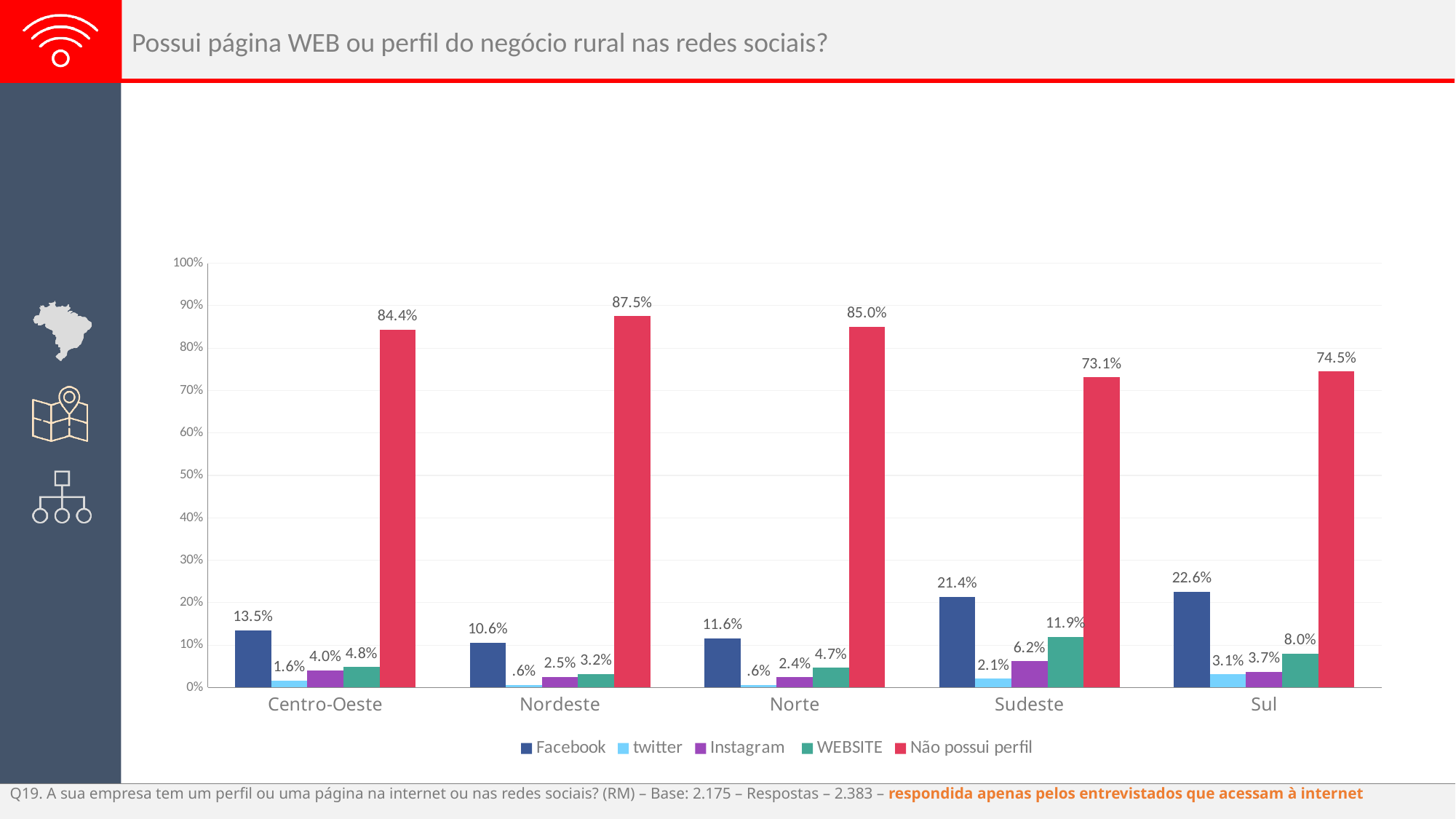
What is the Facebook value for the Sul region? 22.6% How many series does the legend list? 5 What is the Instagram value for the Sudeste region? 6.2% Which region has the larger WEBSITE value, Sudeste or Sul? Sudeste Which region has the lowest Facebook value? Nordeste What is the value for "Não possui perfil" in the Nordeste region? 87.5% Is the value for "Não possui perfil" in Sudeste greater or less than 80%? less What kind of chart is shown on the slide? bar chart Which region has the highest value for "Não possui perfil"? Nordeste What is the difference between the Facebook values for Sul and Sudeste? 1.2% How many regions are shown on the x axis of the chart? 5 What colour represents "Não possui perfil" in the chart? red